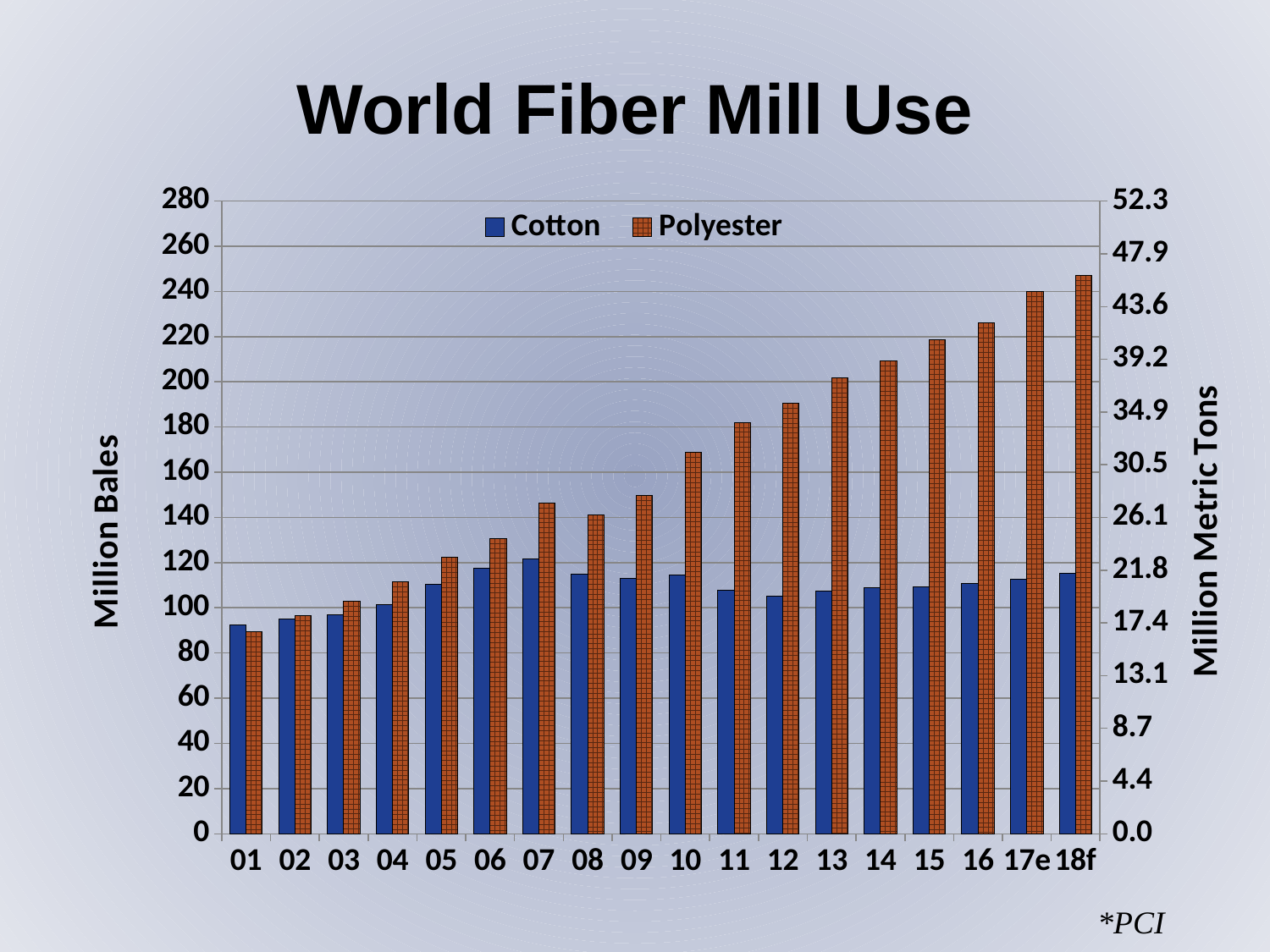
Do the Polyester values generally rise or fall from 01 to 18f? Rise In which year is the Polyester bar the shortest? 01 Is the Polyester bar for 18f greater or less than 240 on the Million Bales axis? greater What kind of chart is shown on the slide? Bar chart Which is larger, the Cotton bar for 07 or the Cotton bar for 12? 07 Is the Polyester bar for 10 greater or less than 160 on the Million Bales axis? greater In which year is the Cotton bar the shortest? 01 How many year categories are shown along the x axis? 18 What is the title of the right-hand vertical axis? Million Metric Tons Is the Cotton value for 01 greater or less than 100 on the Million Bales axis? less How many series does the legend list? 2 In which year is the Polyester bar the tallest? 18f